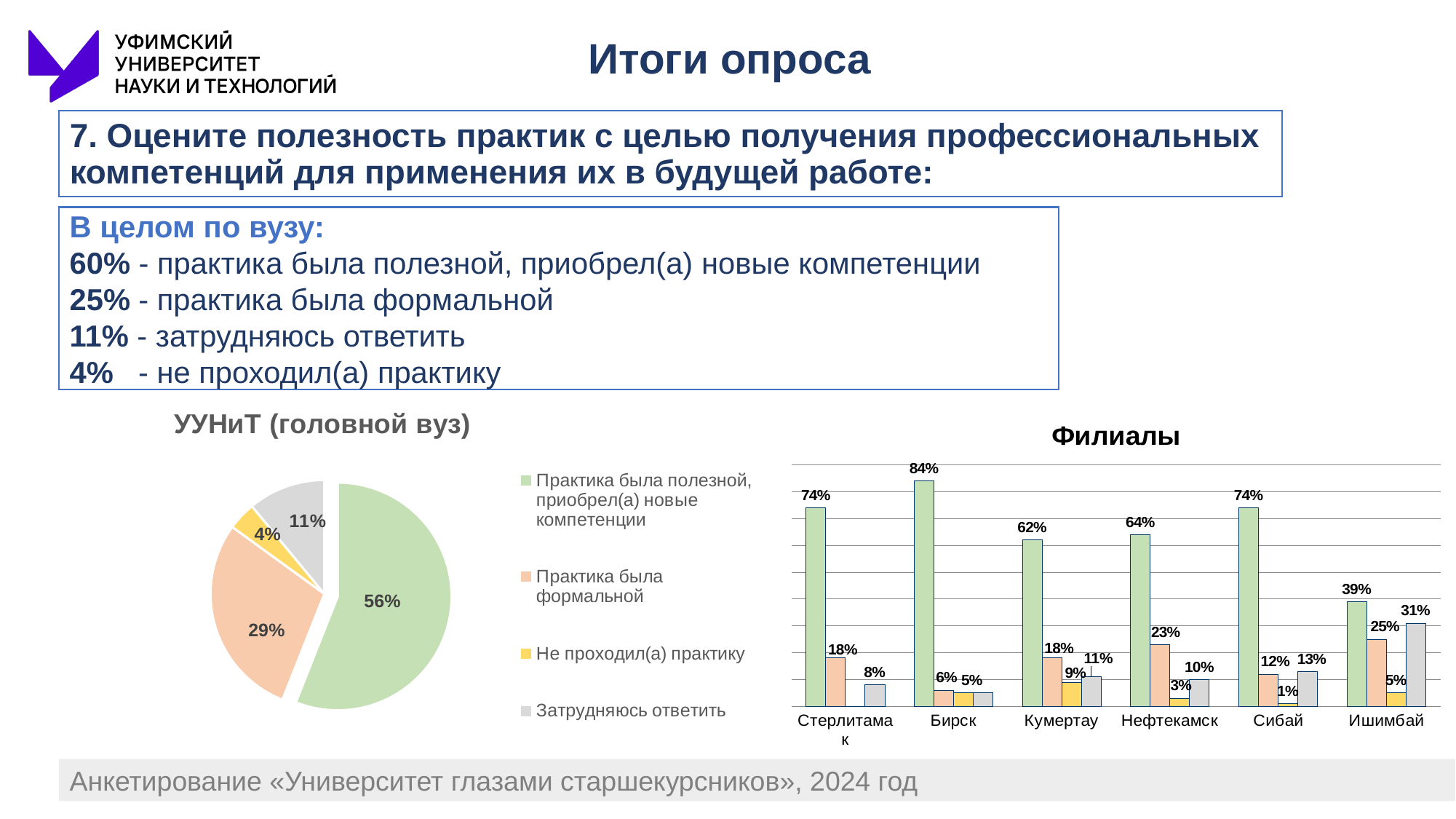
What kind of chart is the 'Филиалы' chart? bar chart In the 'Филиалы' chart, what is the value for 'Затрудняюсь ответить' in Ишимбай? 31% In the 'УУНиТ (головной вуз)' pie chart, which category has the largest slice? Практика была полезной, приобрел(а) новые компетенции In the 'УУНиТ (головной вуз)' pie chart, what share is shown for 'Практика была формальной'? 29% In the 'Филиалы' chart, how many branches are shown on the x axis? 6 How many series does the legend list? 4 In the 'УУНиТ (головной вуз)' pie chart, which category has the smallest slice? Не проходил(а) практику What kind of chart is the 'УУНиТ (головной вуз)' chart? pie chart In the 'Филиалы' chart, what is the value for 'Практика была полезной, приобрел(а) новые компетенции' in Бирск? 84% In the 'Филиалы' chart, what is the difference between the 'Практика была полезной, приобрел(а) новые компетенции' values for Бирск and Кумертау? 22% In the 'Филиалы' chart, which is larger: 'Практика была формальной' in Нефтекамск or in Сибай? Нефтекамск In the 'Филиалы' chart, which branch has the lowest value for 'Практика была полезной, приобрел(а) новые компетенции'? Ишимбай